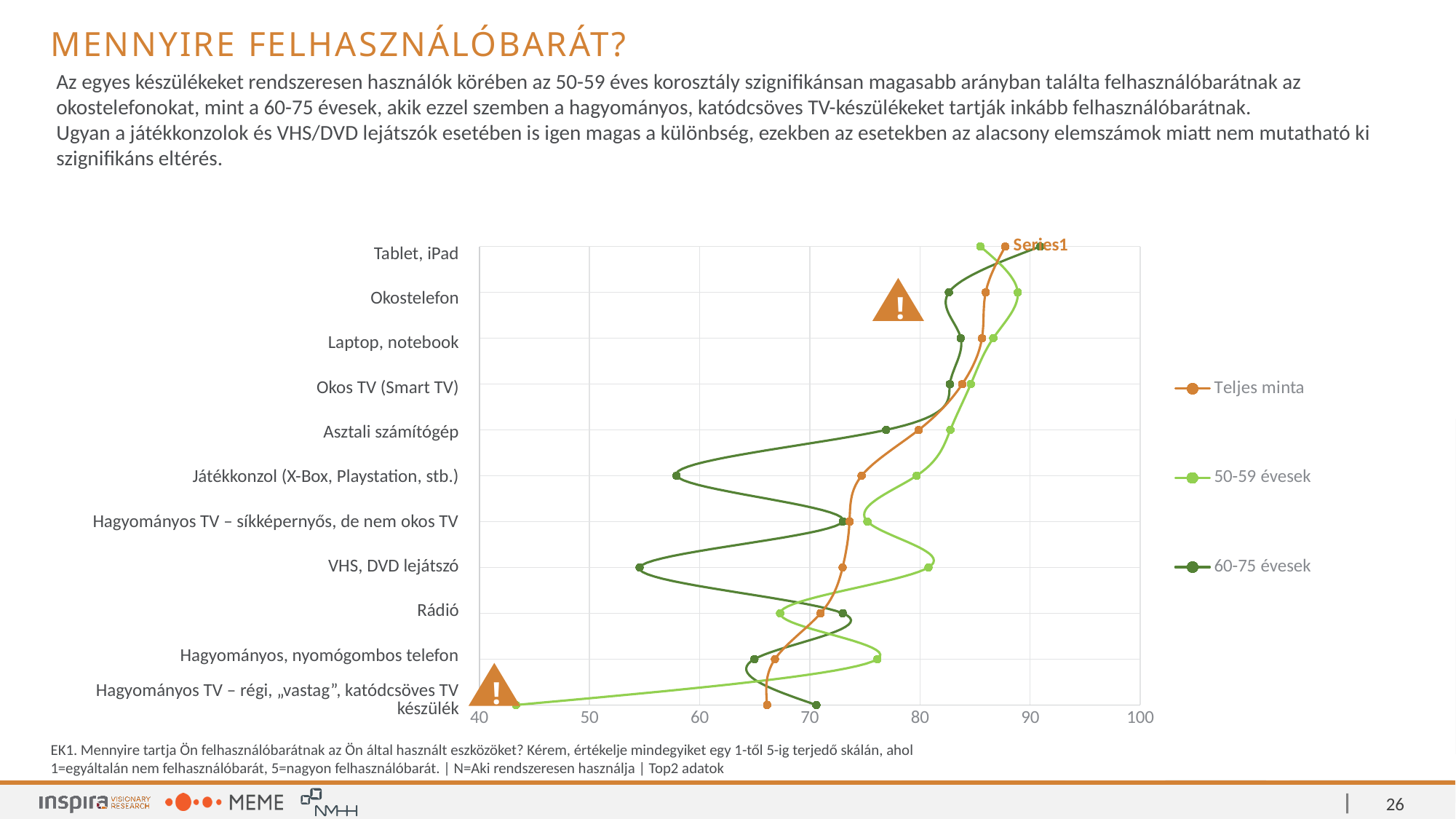
For Játékkonzol (X-Box, Playstation, stb.), which series has the larger value: 50-59 évesek or 60-75 évesek? 50-59 évesek For Hagyományos TV – régi, „vastag”, katódcsöves TV készülék, which series has the larger value: 50-59 évesek or 60-75 évesek? 60-75 évesek Is the value for Okostelefon in the 50-59 évesek series greater or less than 80? greater Is the value for VHS, DVD lejátszó in the 60-75 évesek series greater or less than 60? less What is the lowest value shown on the horizontal axis? 40 Is the value for Hagyományos TV – régi, „vastag”, katódcsöves TV készülék in the 50-59 évesek series greater or less than 50? less Which category has the lowest value in the 60-75 évesek series? VHS, DVD lejátszó What kind of chart is shown on the slide? line chart How many device categories are plotted on the chart? 11 How many series does the legend list? 3 Which series are listed in the legend? Teljes minta, 50-59 évesek, 60-75 évesek